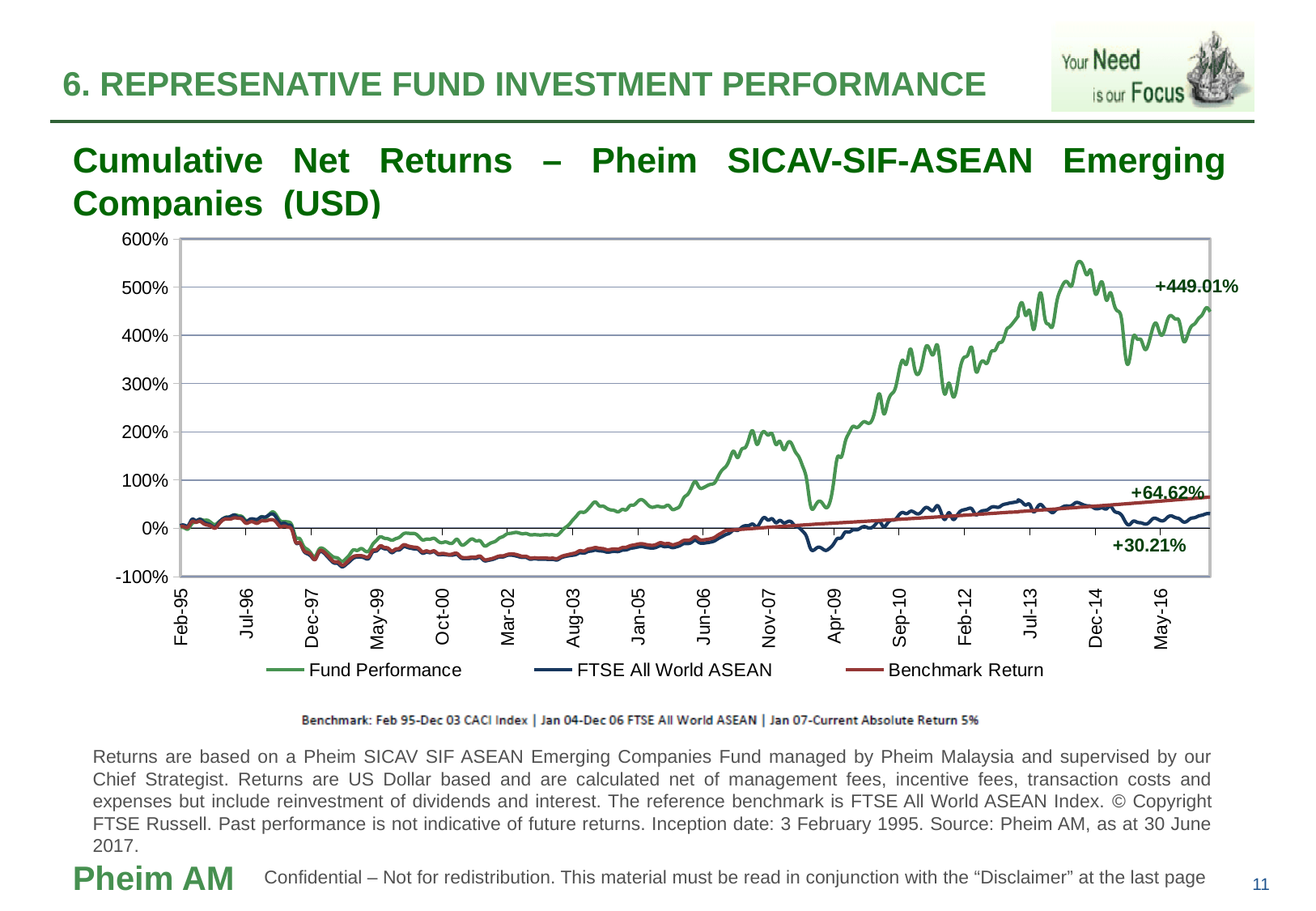
What type of chart is shown on the slide? Line chart What is the final cumulative return labelled for FTSE All World ASEAN? +30.21% What is the final cumulative return labelled for Benchmark Return? +64.62% Is the peak value of the Fund Performance line (around Dec-14) greater or less than 500%? greater Which series ends higher at the right of the chart: FTSE All World ASEAN or Benchmark Return? Benchmark Return How many series does the chart legend list? 3 Which series has the highest cumulative return at the end of the chart? Fund Performance What is the final cumulative return labelled for Fund Performance? +449.01% By how many percentage points does the final Fund Performance return (+449.01%) exceed the final Benchmark Return (+64.62%)? 384.39 percentage points Does the Fund Performance line overall rise or fall from Feb-95 to the end of the chart? Rises What is the difference between the final Benchmark Return (+64.62%) and the final FTSE All World ASEAN return (+30.21%)? 34.41 percentage points What is the first date label shown on the x axis? Feb-95